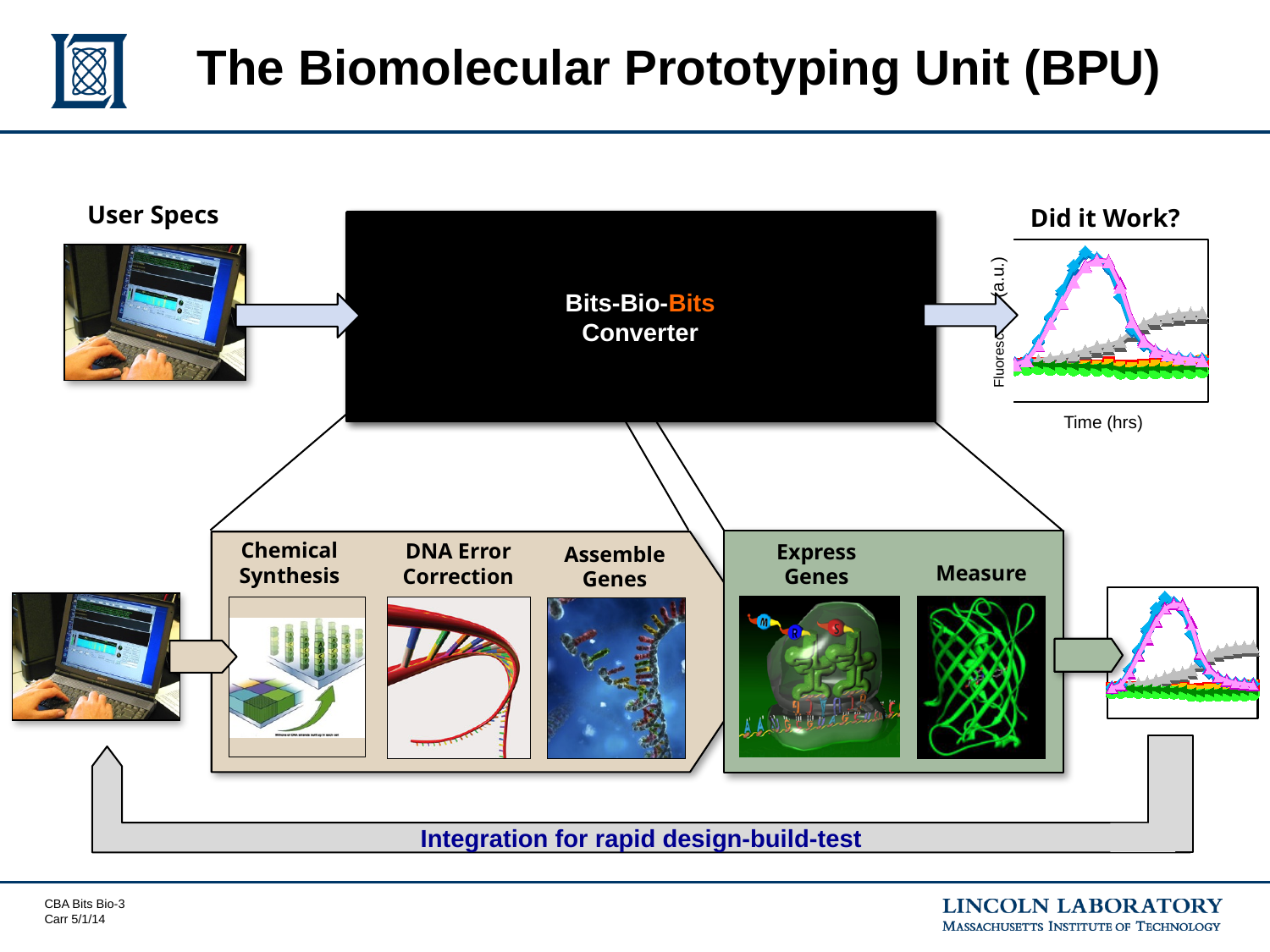
In the "Did it Work?" chart, does the gray series rise or fall as time increases? rise What is the x-axis label of the "Did it Work?" chart in the top right? Time (hrs) What kind of chart is shown under the heading "Did it Work?" in the top right of the slide? line chart What heading appears directly above the chart in the top right of the slide? Did it Work? In the "Did it Work?" chart, does the pink series rise or fall over the first part of the time axis? rise